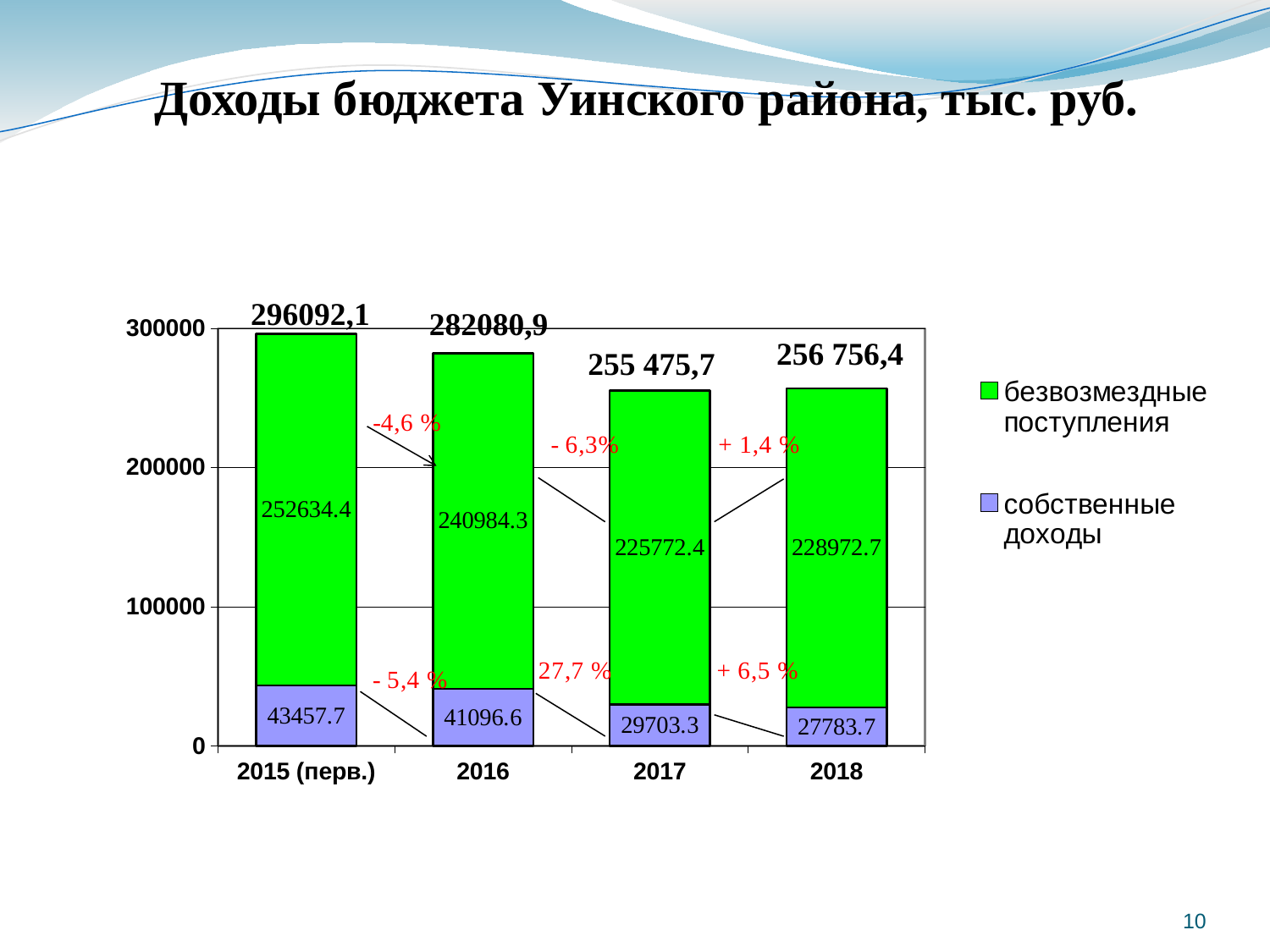
What is the value of безвозмездные поступления for 2016? 240984.3 What is the value of собственные доходы for 2017? 29703.3 What is the total of the stacked bar for 2016? 282080,9 Which year has the highest total budget income? 2015 (перв.) Which year has the larger total income, 2017 or 2018? 2018 Which year has the lowest value of собственные доходы? 2018 What kind of chart is shown on the slide? Stacked bar chart What is the difference between безвозмездные поступления in 2018 and in 2017? 3200.3 How many series does the legend list? 2 Which year has the lowest value of безвозмездные поступления? 2017 Do the values of собственные доходы rise or fall from 2015 (перв.) to 2018? Fall How many years are shown on the x axis? 4